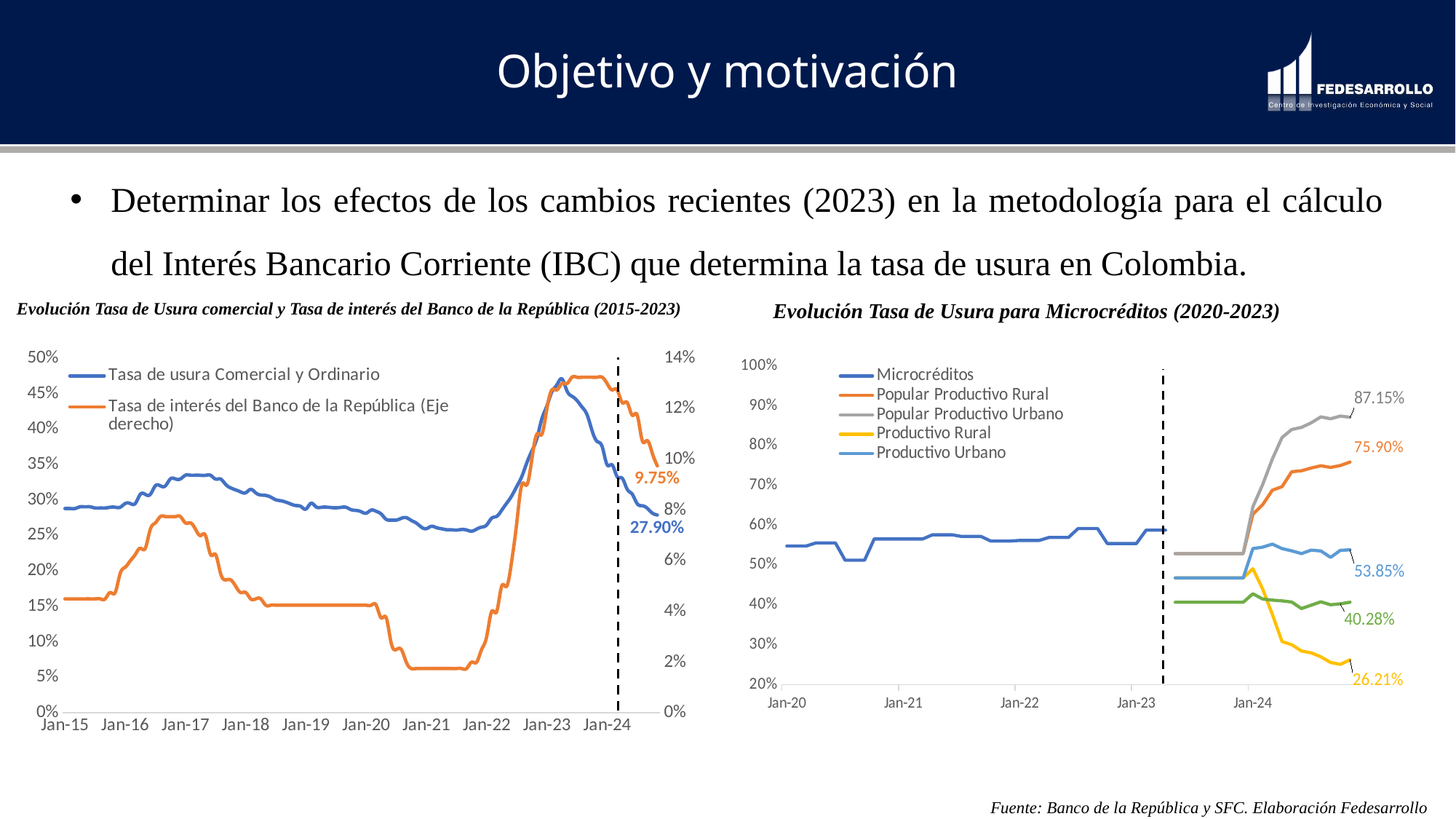
In the right chart, which series has the highest labelled final value? Popular Productivo Urbano In the left chart, what is the labelled final value of the 'Tasa de interés del Banco de la República' series? 9.75% In the right chart, what is the labelled final value of the 'Productivo Rural' series? 26.21% In the right chart, which has the larger labelled final value: 'Productivo Urbano' or 'Productivo Rural'? Productivo Urbano In the right chart, what is the labelled final value of the 'Popular Productivo Urbano' series? 87.15% How many series does the legend of the right chart, 'Evolución Tasa de Usura para Microcréditos (2020-2023)', list? 5 In the left chart, does the 'Tasa de usura Comercial y Ordinario' series rise or fall between Jan-23 and Jan-24? Fall In the right chart, what is the difference between the labelled final values of 'Popular Productivo Urbano' and 'Popular Productivo Rural'? 11.25 percentage points How many series does the legend of the left chart list? 2 What kind of chart is the left chart, 'Evolución Tasa de Usura comercial y Tasa de interés del Banco de la República (2015-2023)'? Line chart In the right chart, what is the labelled final value of the 'Popular Productivo Rural' series? 75.90% In the left chart, what is the labelled final value of the 'Tasa de usura Comercial y Ordinario' series? 27.90%